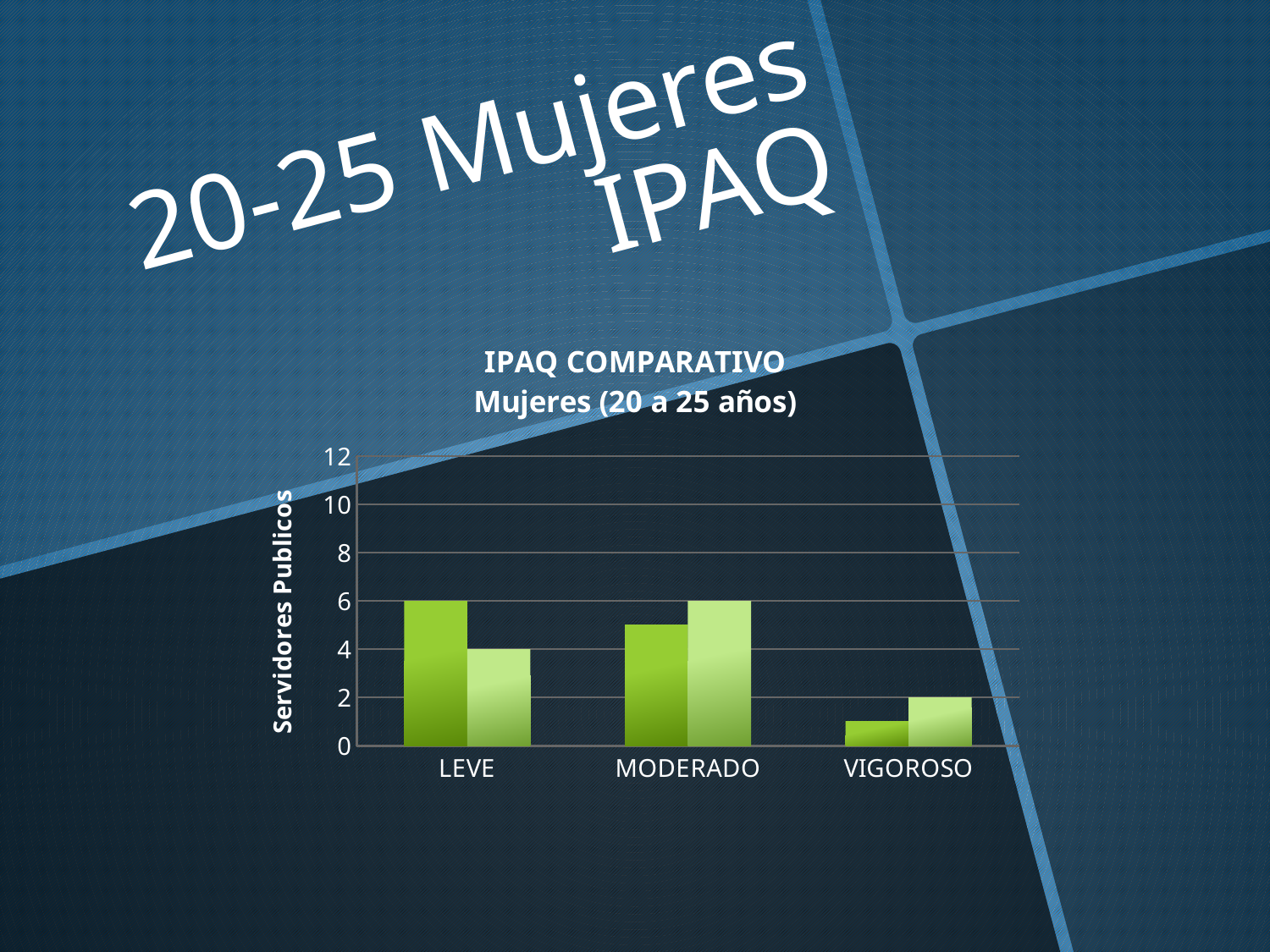
Is the value of the dark green bar for VIGOROSO greater or less than 2? less How many categories are shown on the x axis of the chart? 3 What is the value of the light green bar for MODERADO? 6 What is the difference between the dark green and light green bars for LEVE? 2 What is the value of the dark green bar for LEVE? 6 What is the title of the y axis of the chart? Servidores Publicos What is the value of the light green bar for LEVE? 4 What is the value of the light green bar for VIGOROSO? 2 Is the value of the dark green bar for MODERADO greater or less than 4? greater Which category has the lowest light green bar? VIGOROSO Which category has the highest dark green bar? LEVE What kind of chart is shown on the slide? bar chart